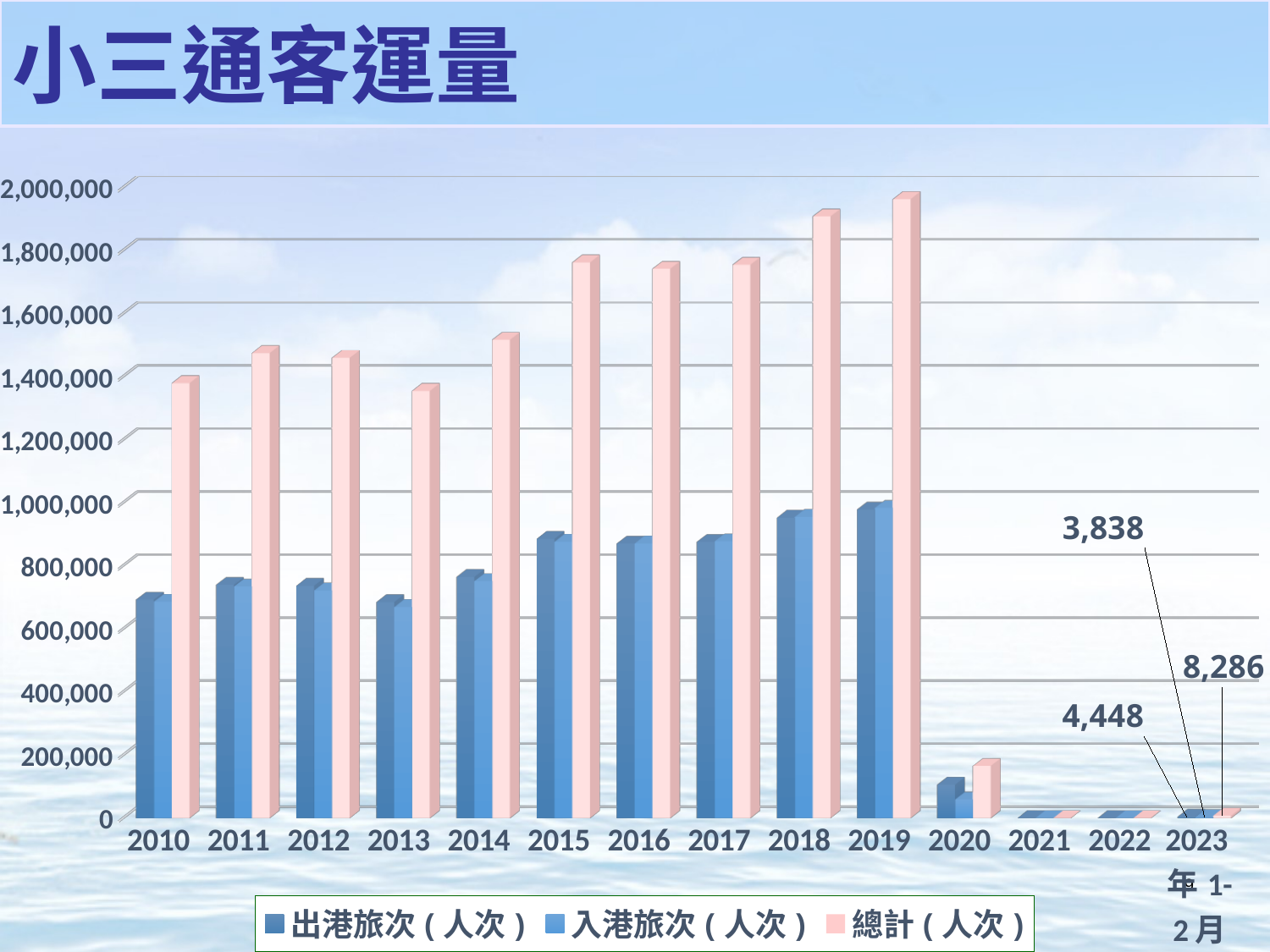
What is the value of 總計（人次） for 2023年1-2月? 8,286 Is the 總計（人次） value for 2019 greater or less than 1,800,000? greater Is the 總計（人次） value for 2020 greater or less than 400,000? less How many series does the legend list? 3 Which is larger, the 總計（人次） for 2014 or for 2013? 2014 Between 2019 and 2021, do the 總計（人次） values rise or fall? fall What is the value of 入港旅次（人次） for 2023年1-2月? 3,838 What is the value of 出港旅次（人次） for 2023年1-2月? 4,448 What is the title of the slide's chart? 小三通客運量 Is the 出港旅次（人次） value for 2013 greater or less than 800,000? less Which year has the highest 總計（人次）? 2019